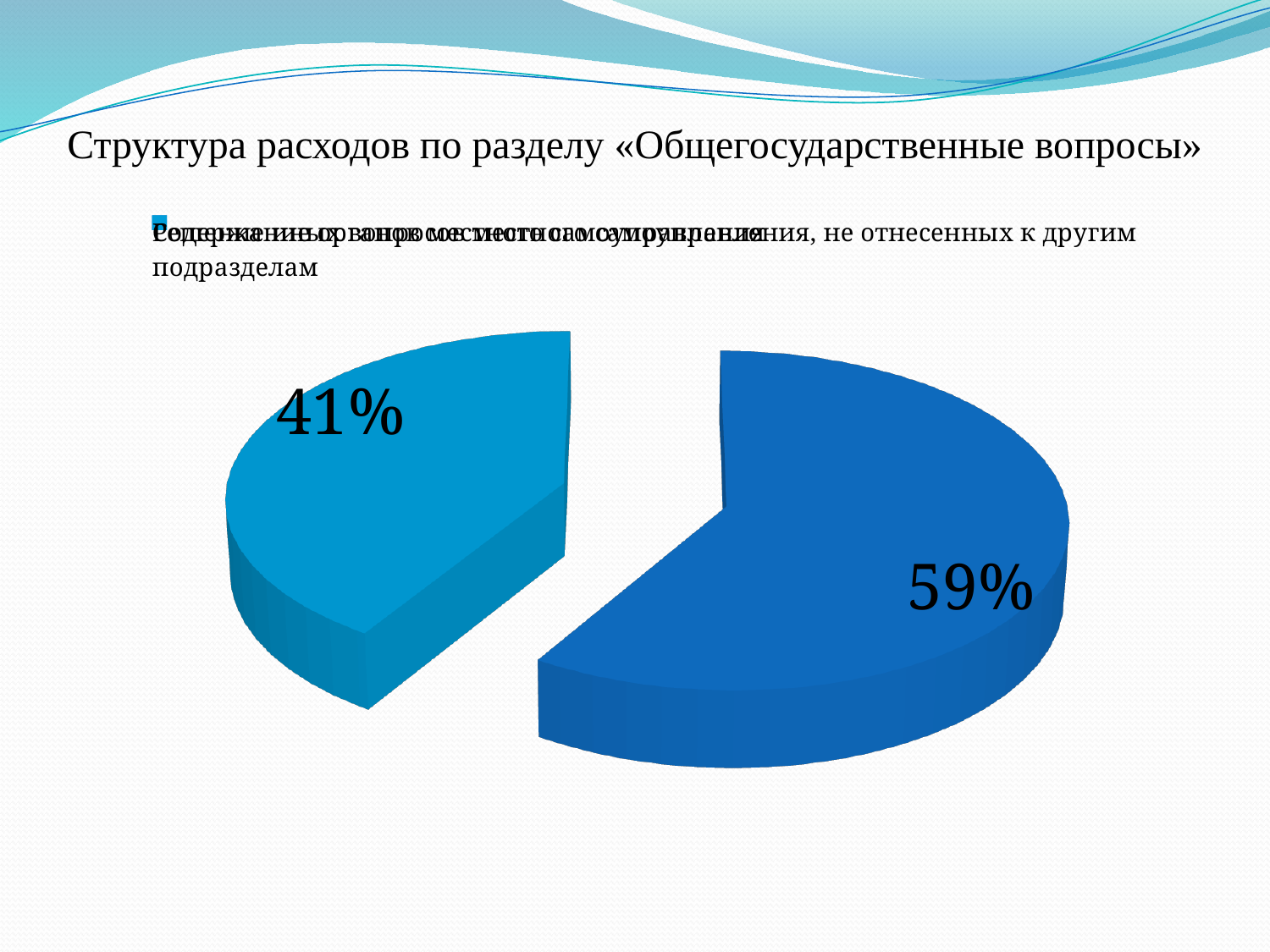
How many slices does the pie chart have? 2 What is the title of the slide containing the pie chart? Структура расходов по разделу «Общегосударственные вопросы» What is the value shown on the larger, darker blue slice of the pie chart? 59% By how many percentage points does the larger slice exceed the smaller slice? 18 What is the smallest share shown in the pie chart? 41% Is the share of the lighter blue slice greater or less than 50%? less What is the total of the two percentages shown on the pie chart? 100% What kind of chart is shown on the slide? pie chart What is the value shown on the smaller, lighter blue slice of the pie chart? 41% Which slice is larger: the darker blue slice on the right or the lighter blue slice on the left? the darker blue slice on the right What is the largest share shown in the pie chart? 59%